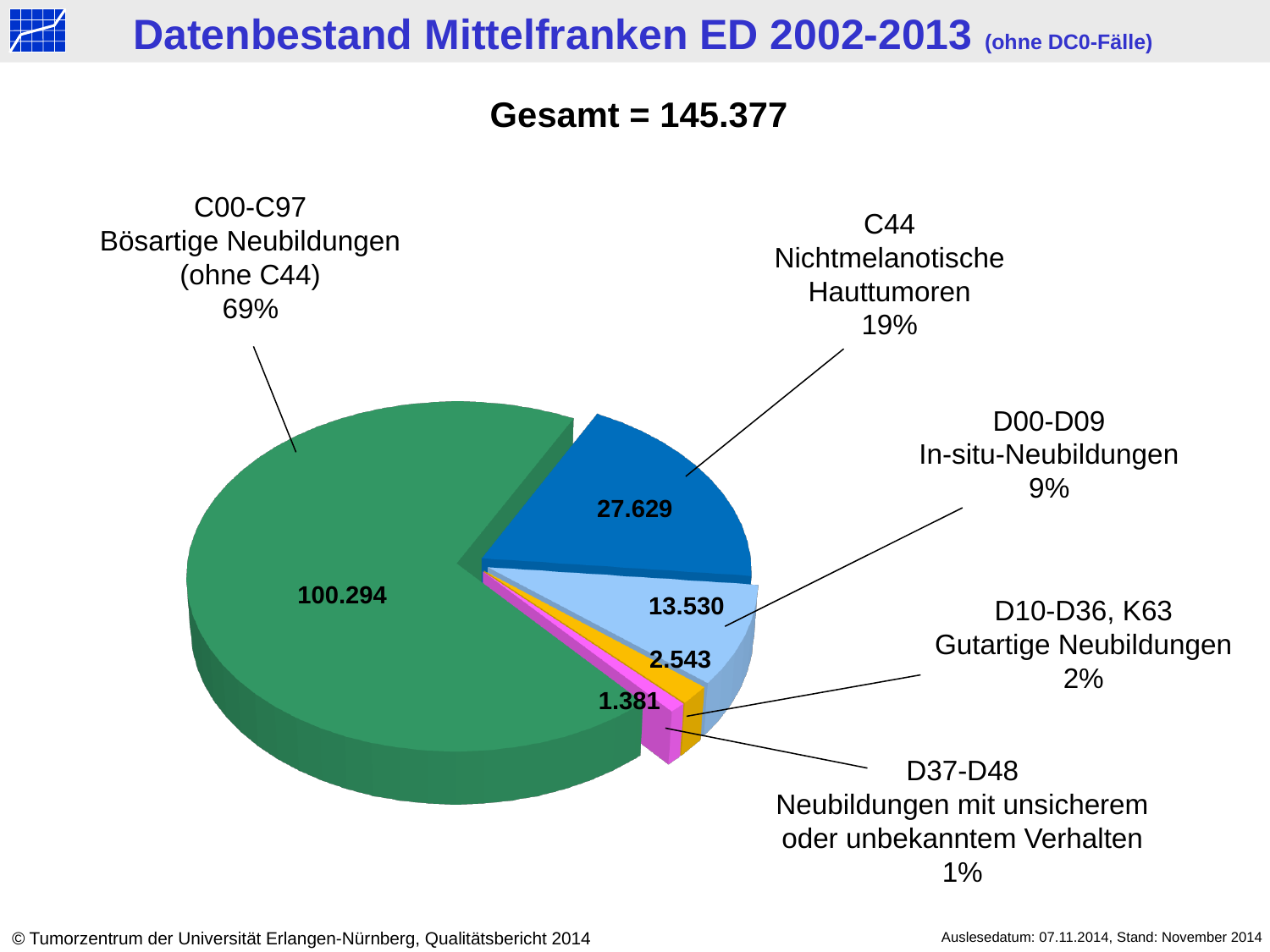
What is the value for C44 Nichtmelanotische Hauttumoren? 27.629 What total is stated above the pie chart (Gesamt)? 145.377 What is the value for D37-D48 Neubildungen mit unsicherem oder unbekanntem Verhalten? 1.381 What is the value for C00-C97 Bösartige Neubildungen (ohne C44)? 100.294 What kind of chart is shown on the slide? pie chart What share of the pie does C44 Nichtmelanotische Hauttumoren represent? 19% What is the value for D00-D09 In-situ-Neubildungen? 13.530 Which category has the smallest slice? D37-D48 Neubildungen mit unsicherem oder unbekanntem Verhalten What is the difference between the values for C44 and D00-D09? 14.099 How many slices does the pie chart have? 5 Which category has the largest slice? C00-C97 Bösartige Neubildungen (ohne C44) What share of the pie does D10-D36, K63 Gutartige Neubildungen represent? 2%